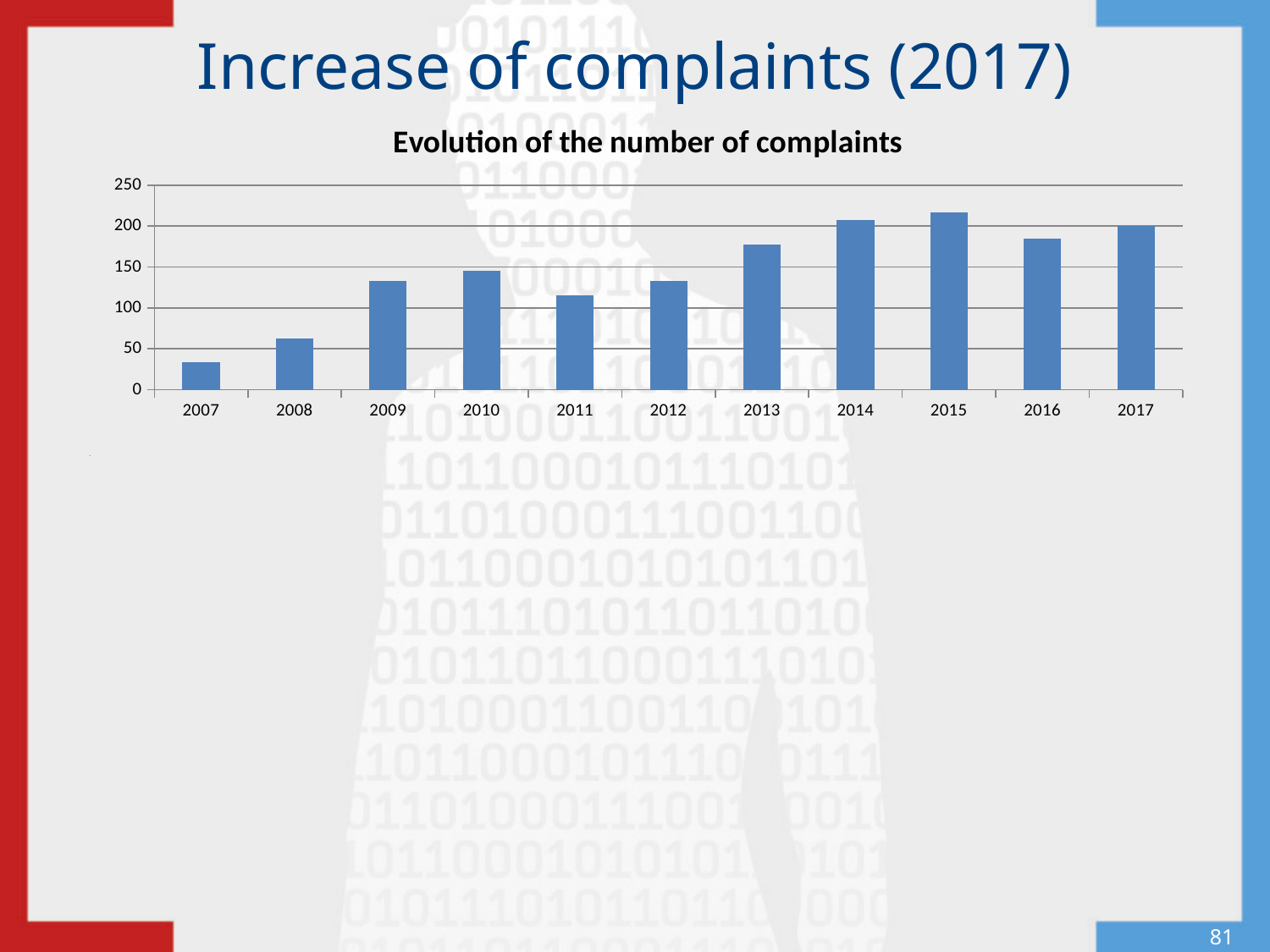
What is the title of the chart? Evolution of the number of complaints How many years are shown on the x axis of the chart? 11 Which year has more complaints, 2010 or 2011? 2010 Overall, do the number of complaints rise or fall from 2007 to 2017? rise Is the value for 2011 greater or less than 150? less Is the value for 2007 greater or less than 50? less Is the value for 2013 greater or less than 150? greater Which year has the lowest number of complaints? 2007 Which year has the highest number of complaints? 2015 What kind of chart is shown on the slide? bar chart Which year has more complaints, 2016 or 2015? 2015